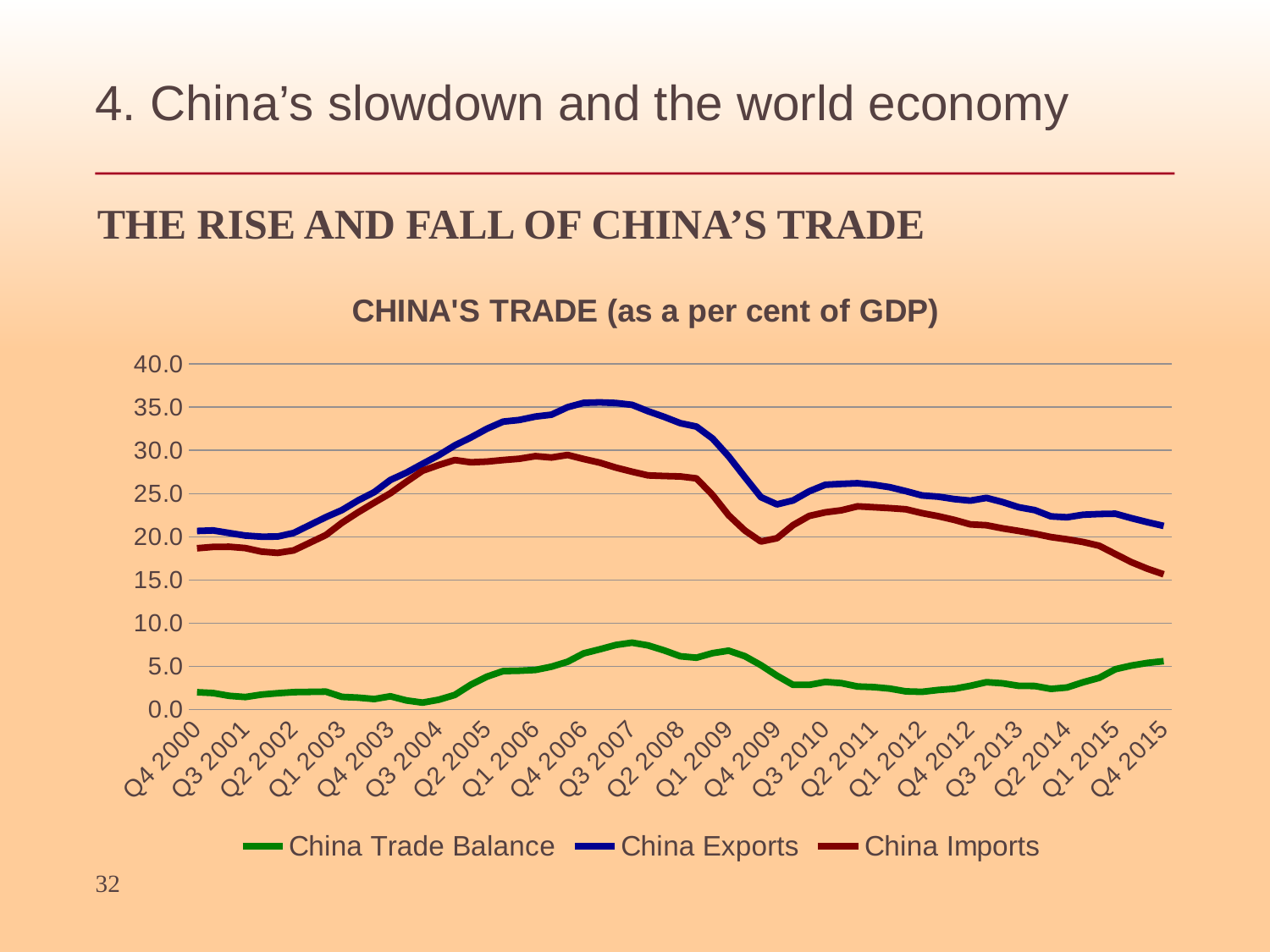
Do the values for China Exports rise or fall from Q4 2000 to Q4 2006? rise How many series does the legend list? 3 Which series is drawn in green? China Trade Balance Is the value for China Trade Balance at Q3 2007 greater or less than 5.0? greater At Q4 2015, which is larger, China Exports or China Imports? China Exports Which series has the lowest values across the whole period? China Trade Balance Is the value for China Exports at Q4 2006 greater or less than 30.0? greater What kind of chart is shown on the slide? line chart Which series has the highest values across the whole period? China Exports Is the value for China Imports at Q4 2015 greater or less than 20.0? less What is the title of the chart? CHINA'S TRADE (as a per cent of GDP)